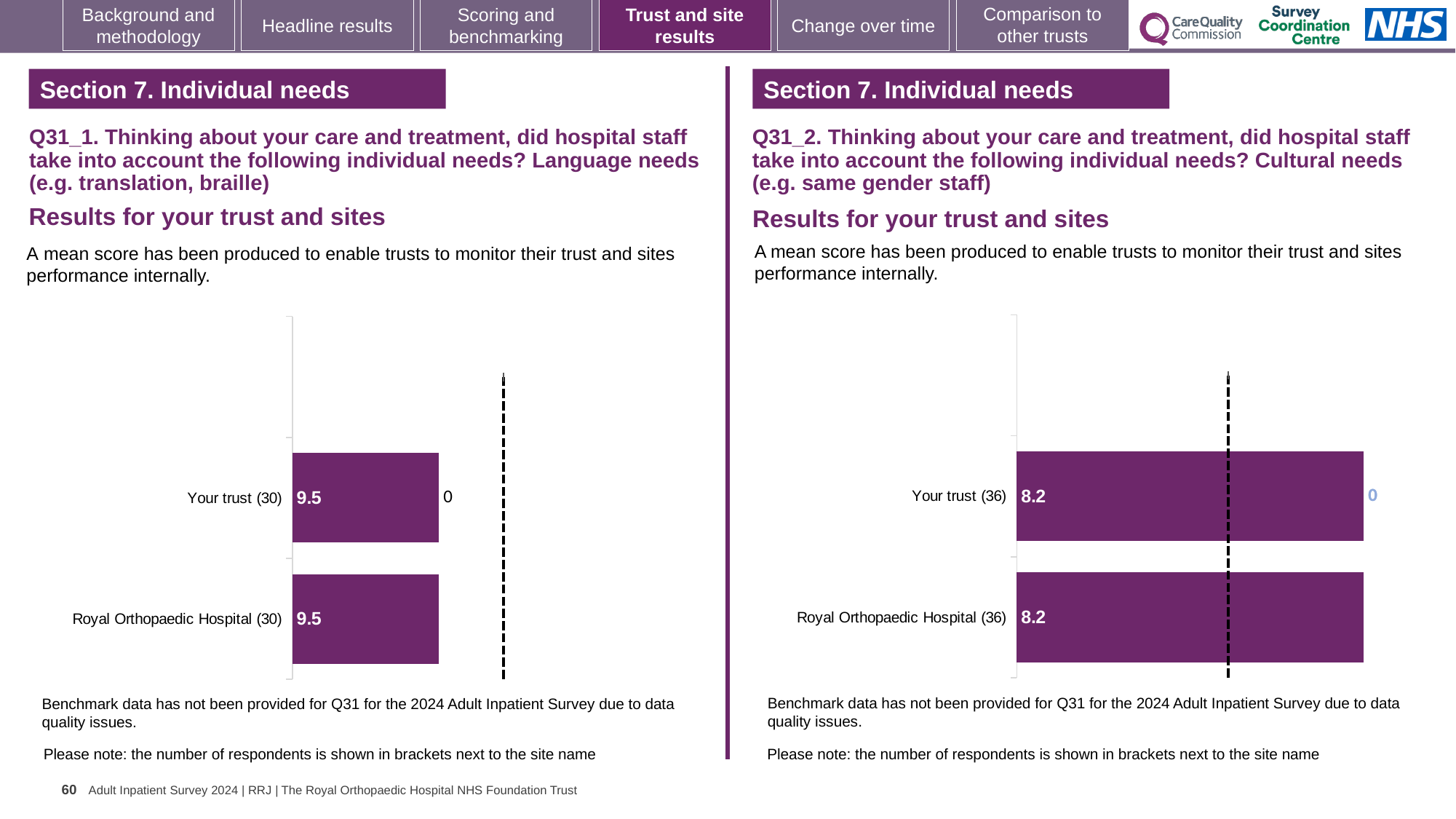
In the right chart (Q31_2, Cultural needs), what is the mean score for Royal Orthopaedic Hospital? 8.2 In the left chart (Q31_1, Language needs), what is the mean score for Royal Orthopaedic Hospital? 9.5 In the left chart (Q31_1, Language needs), what is the difference between the scores for Your trust and Royal Orthopaedic Hospital? 0 How many bars are plotted in the right chart (Q31_2, Cultural needs)? 2 In the right chart (Q31_2, Cultural needs), how many respondents are shown in brackets next to Royal Orthopaedic Hospital? 36 What type of chart is used in the left chart (Q31_1, Language needs)? Bar chart Is the score for Your trust in the right chart (Q31_2, Cultural needs) higher or lower than the score for Your trust in the left chart (Q31_1, Language needs)? Lower In the left chart (Q31_1, Language needs), how many respondents are shown in brackets next to Your trust? 30 In the right chart (Q31_2, Cultural needs), what is the mean score for Your trust? 8.2 How many bars are plotted in the left chart (Q31_1, Language needs)? 2 In the right chart (Q31_2, Cultural needs), what is the difference between the scores for Your trust and Royal Orthopaedic Hospital? 0 In the left chart (Q31_1, Language needs), what is the mean score for Your trust? 9.5